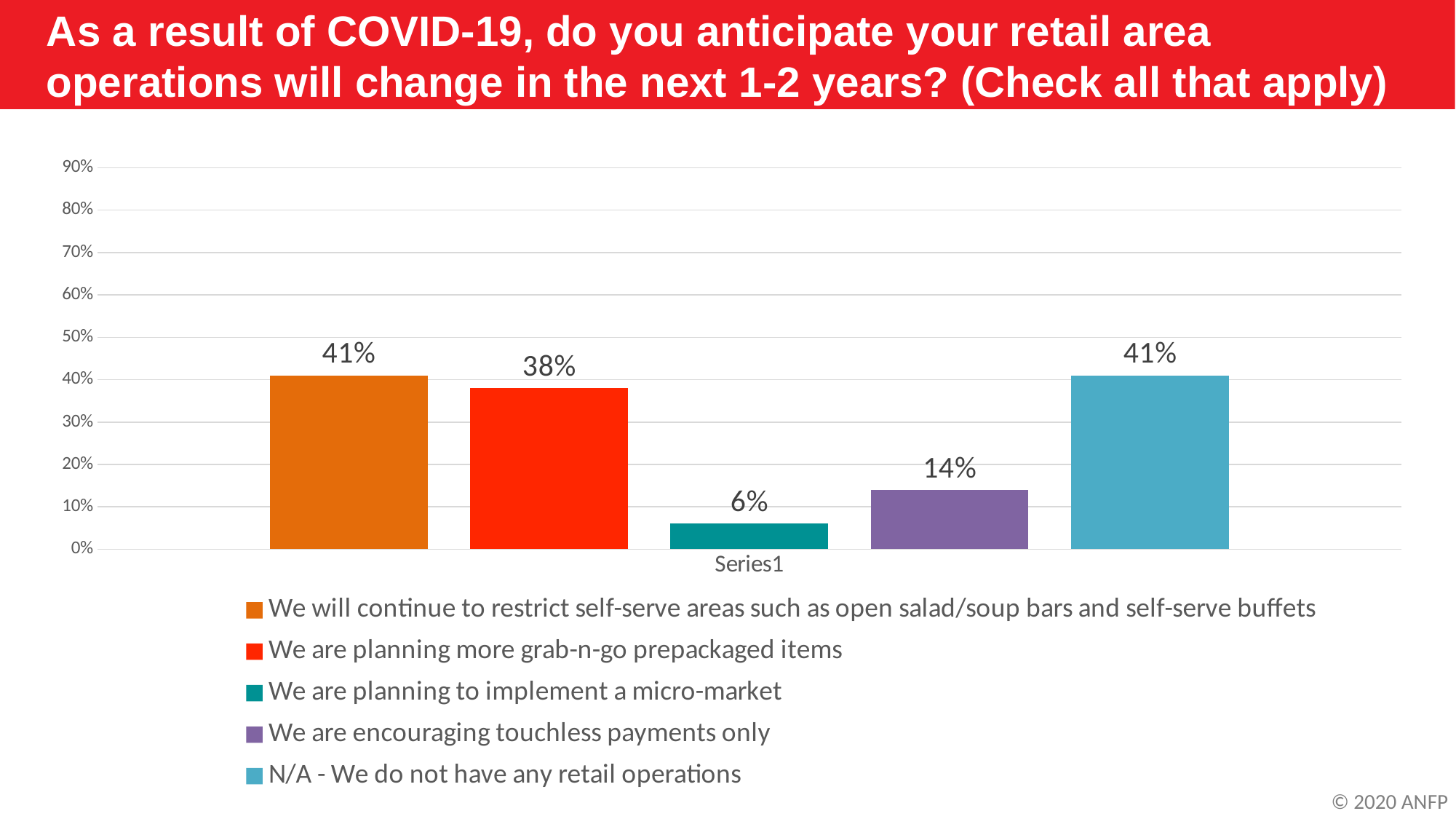
What percentage of respondents are encouraging touchless payments only? 14% Which is larger: the percentage planning more grab-n-go prepackaged items or the percentage encouraging touchless payments only? We are planning more grab-n-go prepackaged items What colour is the bar for 'We are encouraging touchless payments only'? Purple Which response has the lowest percentage? We are planning to implement a micro-market What percentage of respondents said they will continue to restrict self-serve areas such as open salad/soup bars and self-serve buffets? 41% Is the value for planning to implement a micro-market greater or less than 10%? less What kind of chart is shown on the slide? Bar chart How many bars are shown in the chart? 5 What is the difference in percentage points between planning more grab-n-go prepackaged items and encouraging touchless payments only? 24 What percentage of respondents are planning more grab-n-go prepackaged items? 38% What percentage of respondents are planning to implement a micro-market? 6% What percentage of respondents answered N/A - We do not have any retail operations? 41%